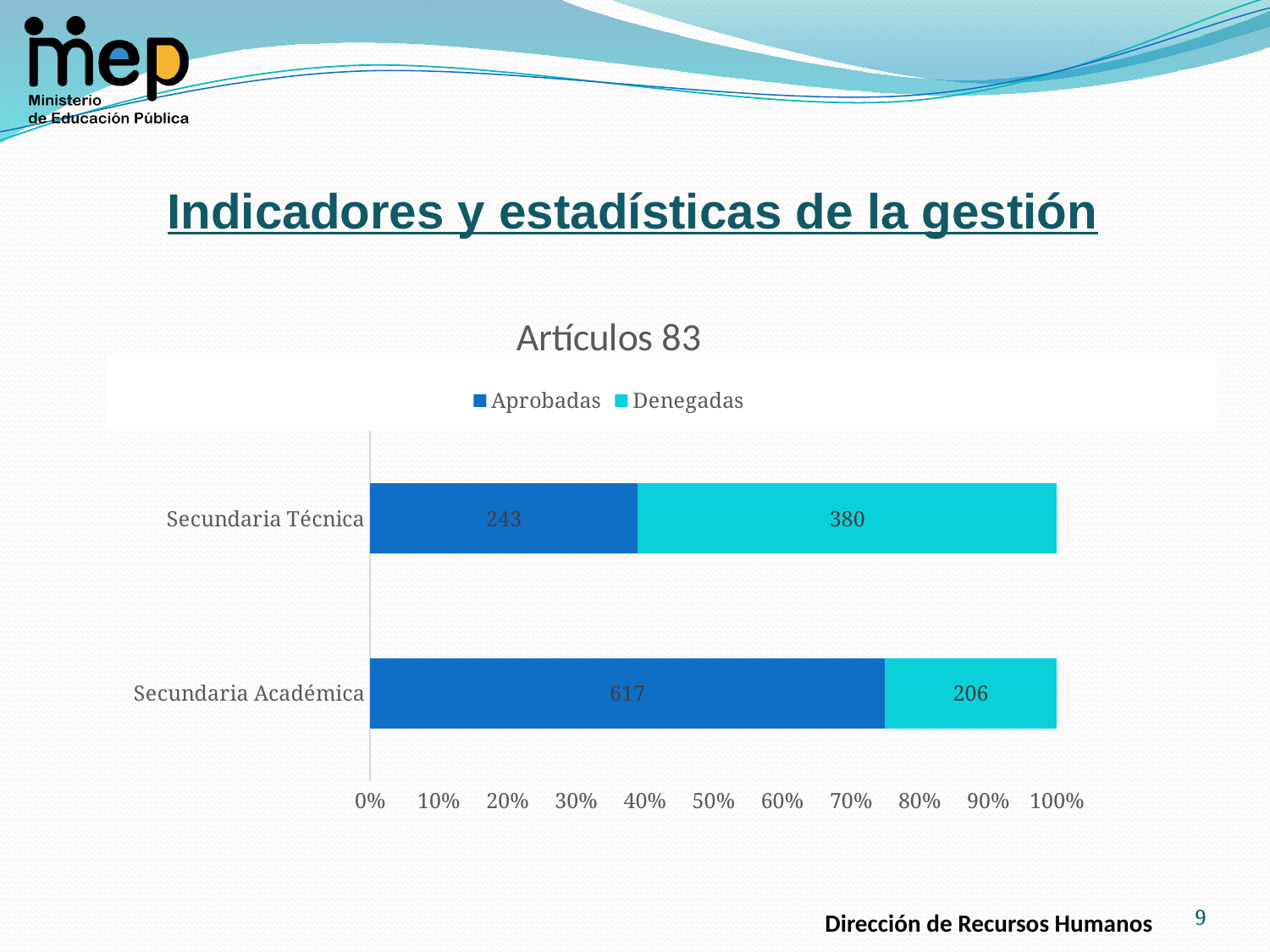
What is the Aprobadas value for Secundaria Académica? 617 What is the Denegadas value for Secundaria Técnica? 380 What is the title of the chart? Artículos 83 What is the Denegadas value for Secundaria Académica? 206 How many categories are shown on the chart? 2 What is the Aprobadas value for Secundaria Técnica? 243 What is the total of the Aprobadas and Denegadas values for Secundaria Técnica? 623 For Secundaria Técnica, which is larger: Aprobadas or Denegadas? Denegadas Which category has the lowest Denegadas value? Secundaria Académica Which category has the highest Aprobadas value? Secundaria Académica What is the difference between the Aprobadas values for Secundaria Académica and Secundaria Técnica? 374 How many series does the legend list? 2